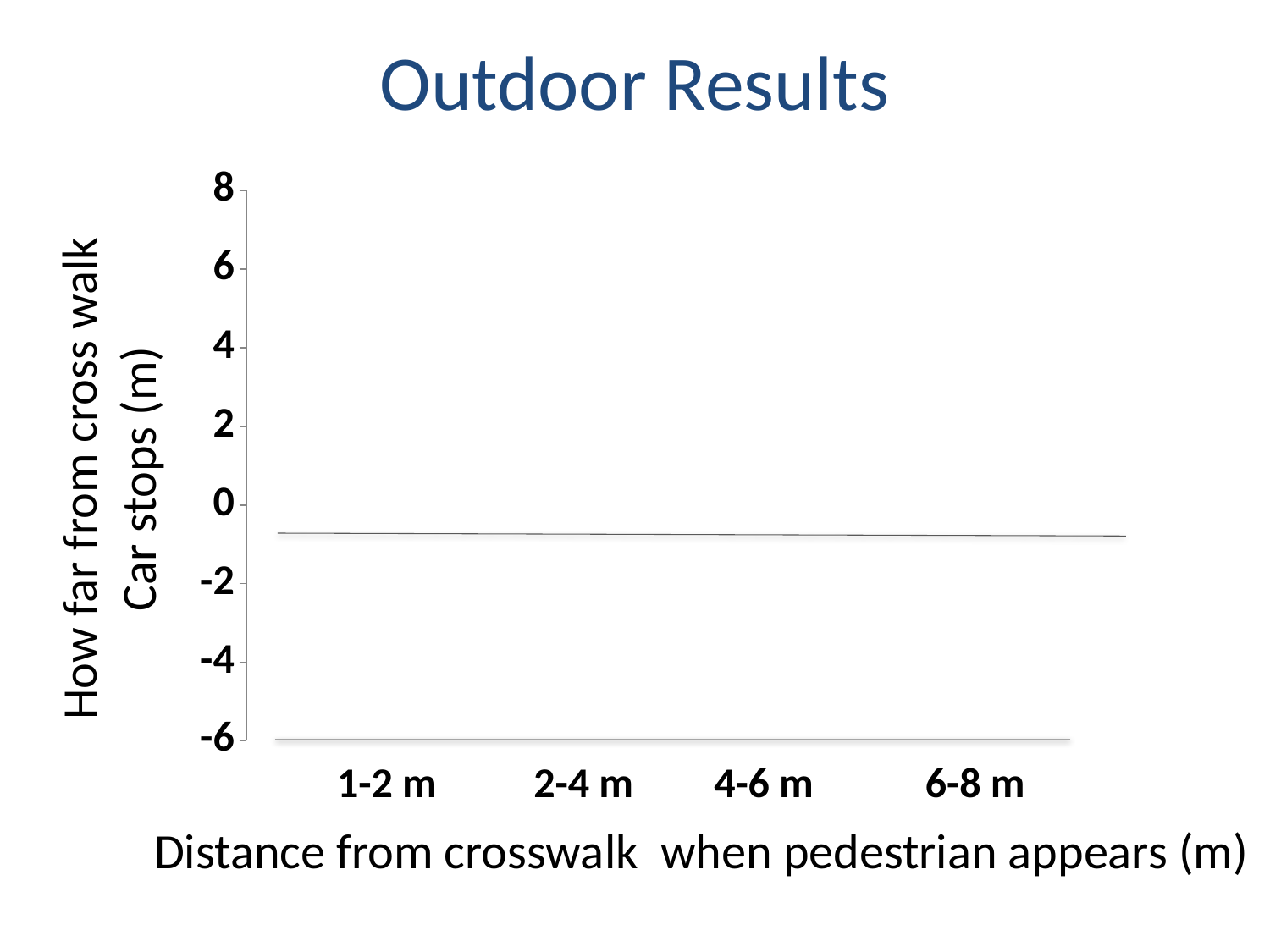
What is the title of the slide containing the chart? Outdoor Results How many categories are shown on the x axis of the chart? 4 What is the x-axis title of the chart? Distance from crosswalk when pedestrian appears (m) Is the horizontal line plotted across the chart at a value greater or less than -2? greater Is the horizontal line plotted across the chart at a value greater or less than 0? less